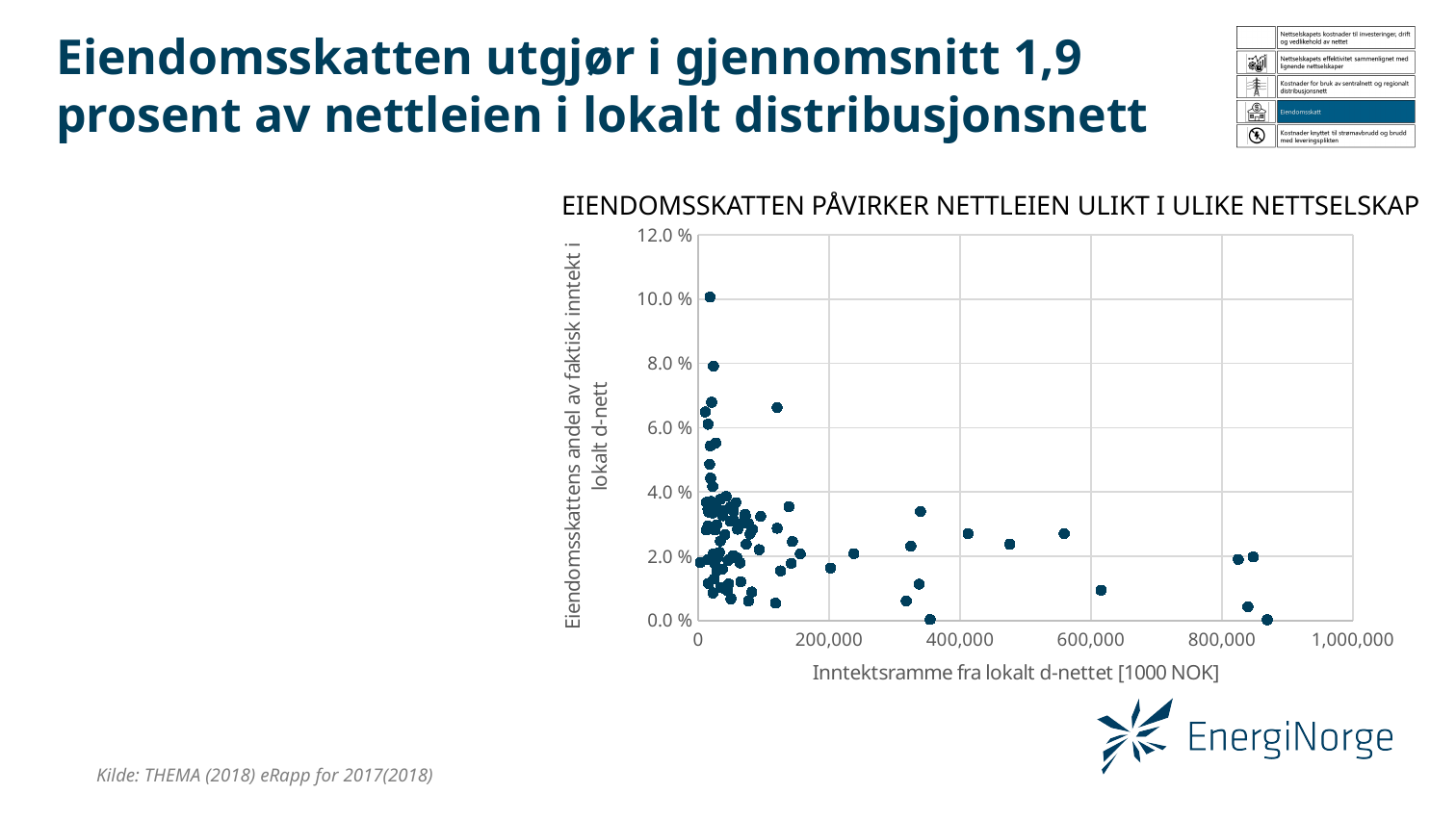
Is the y value of the highest point in the chart greater or less than 8.0 %? greater What is the highest value shown on the y axis of the chart? 12.0 % What is the title of the chart? EIENDOMSSKATTEN PÅVIRKER NETTLEIEN ULIKT I ULIKE NETTSELSKAP Is the y value of the point with the largest x value greater or less than 2.0 %? less Is the y value of the second-highest point in the chart greater or less than 6.0 %? greater What is the highest value shown on the x axis of the chart? 1,000,000 What kind of chart is shown on the slide? scatter chart Are the highest y values in the chart found at low or high x values? low What is the label of the x axis of the chart? Inntektsramme fra lokalt d-nettet [1000 NOK]